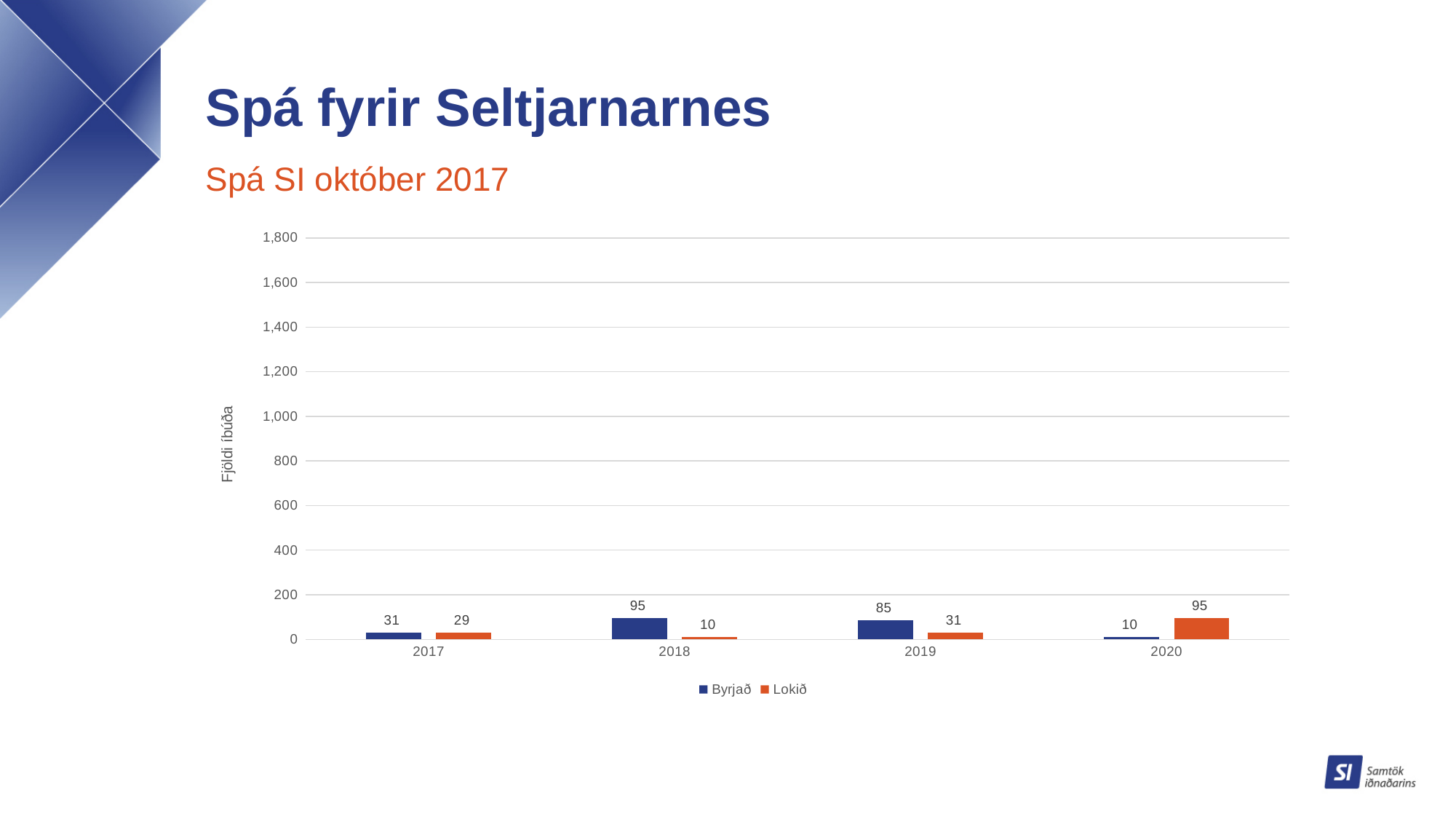
What is the Lokið value for 2019? 31 What kind of chart is shown on the slide? Bar chart What is the Byrjað value for 2018? 95 How many series does the legend list? 2 What is the Lokið value for 2017? 29 What is the label of the vertical axis? Fjöldi íbúða Which is larger in 2019, Byrjað or Lokið? Byrjað How many years are shown on the x axis? 4 What is the Byrjað value for 2020? 10 In which year is the Byrjað value lowest? 2020 What is the difference between the Byrjað and Lokið values in 2018? 85 In which year is the Lokið value highest? 2020